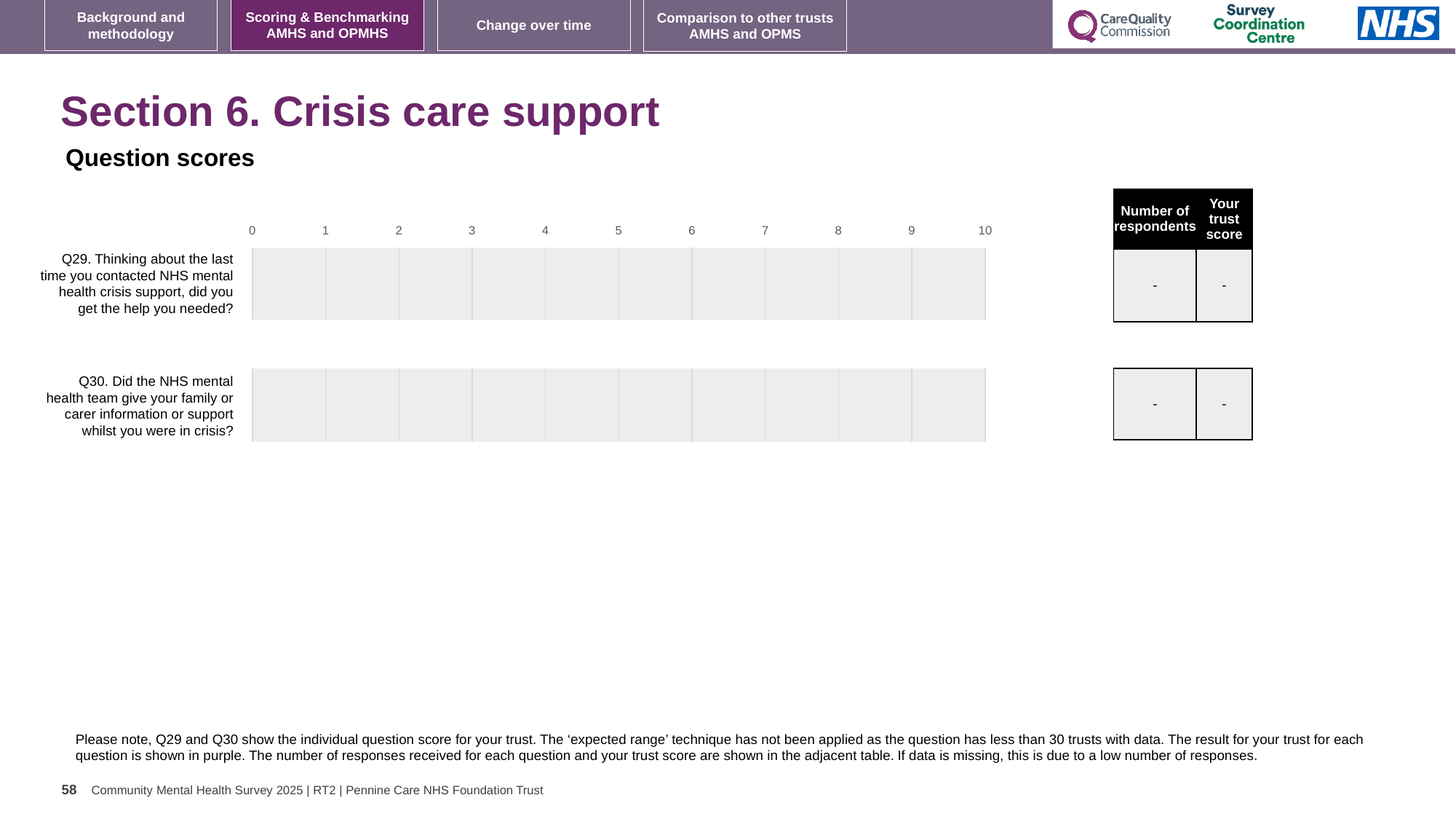
What is the highest value shown on the chart's x axis? 10 What is the number of respondents shown for Q30 in the adjacent table? - What kind of chart is shown on the slide? bar chart What is the lowest value shown on the chart's x axis? 0 What is the trust score shown for Q29 in the adjacent table? - What is the number of respondents shown for Q29 in the adjacent table? - What is the trust score shown for Q30 in the adjacent table? - Which question label appears first (at the top) on the chart? Q29 How many questions (categories) are listed on the chart? 2